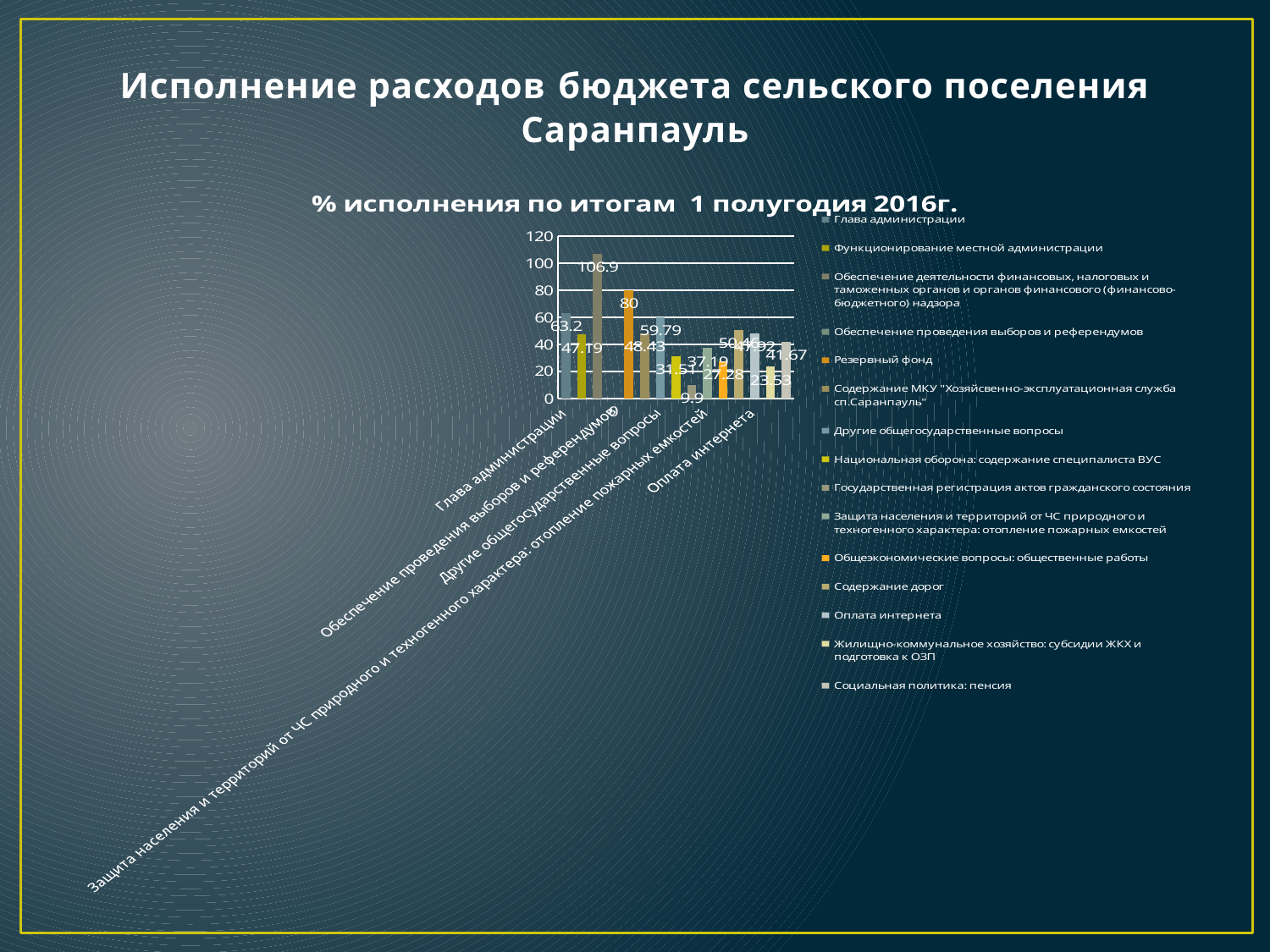
What is the value for Резервный фонд? 80 Is the value for Резервный фонд greater or less than 60? greater Which series has the highest value in the chart? Обеспечение деятельности финансовых, налоговых и таможенных органов и органов финансового (финансово-бюджетного) надзора What is the highest value shown in the chart? 106.9 How many series does the chart legend list? 15 What is the difference between the highest value (106.9) and the value for Резервный фонд (80)? 26.9 Which is larger, the value for Резервный фонд or the value for Глава администрации? Резервный фонд What is the title of the chart? % исполнения по итогам 1 полугодия 2016г. Is the value for Функционирование местной администрации greater or less than 60? less What kind of chart is shown on the slide? bar chart What is the value for Глава администрации? 63.2 What is the value for Функционирование местной администрации? 47.19